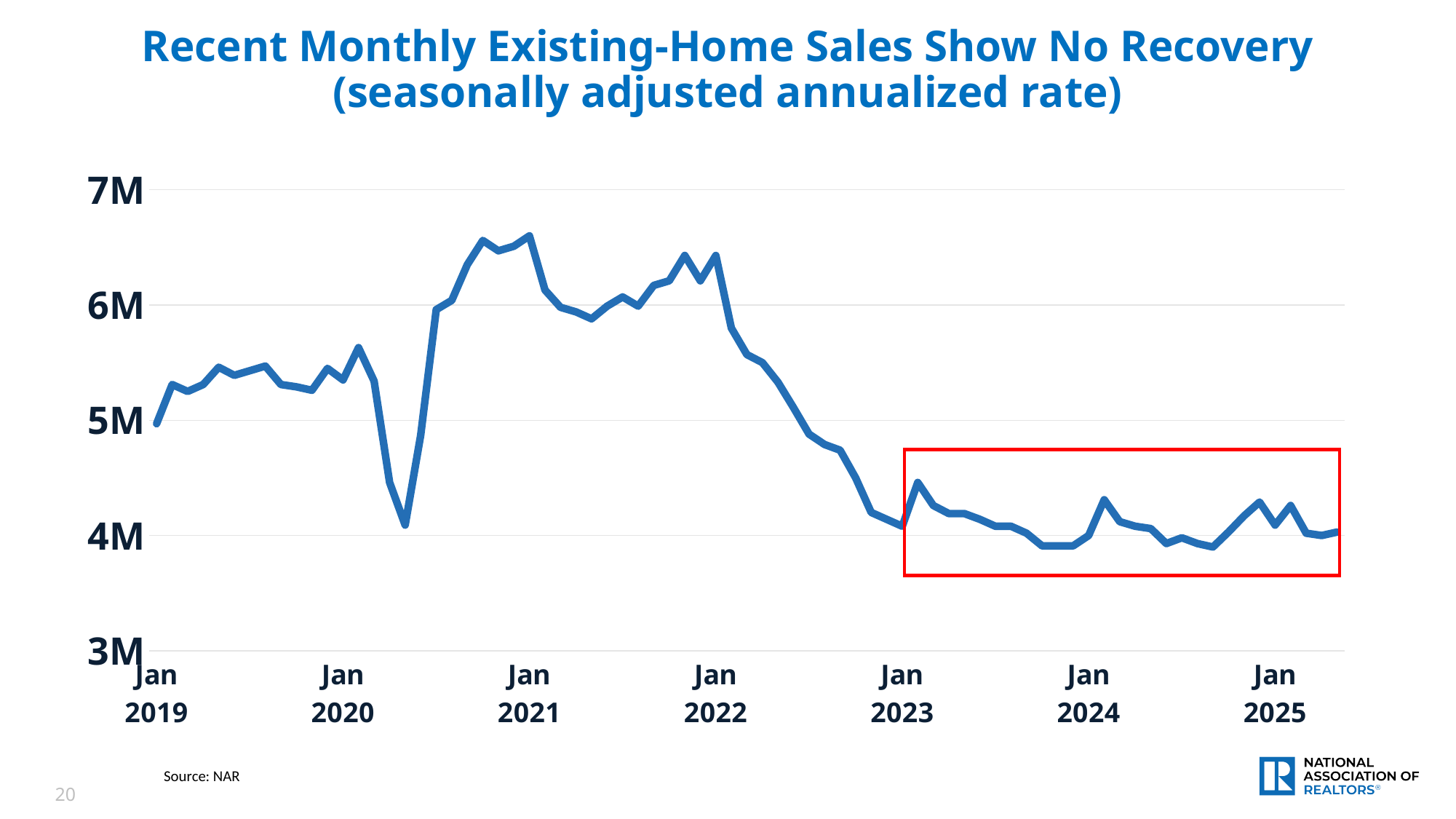
What type of chart is shown on the slide? line chart Is the value at Jan 2022 greater or less than 6M? greater Is the value at Jan 2024 greater or less than 5M? less How many year labels are shown on the x axis? 7 Is the highest point on the line greater or less than 6M? greater Does the line rise or fall between Jan 2022 and Jan 2023? fall Does the line rise or fall overall between Jan 2020 and Jan 2021? rise Around which x-axis label does the line reach its highest point? Jan 2021 What source is cited for the chart? NAR What is the title of the chart? Recent Monthly Existing-Home Sales Show No Recovery (seasonally adjusted annualized rate)